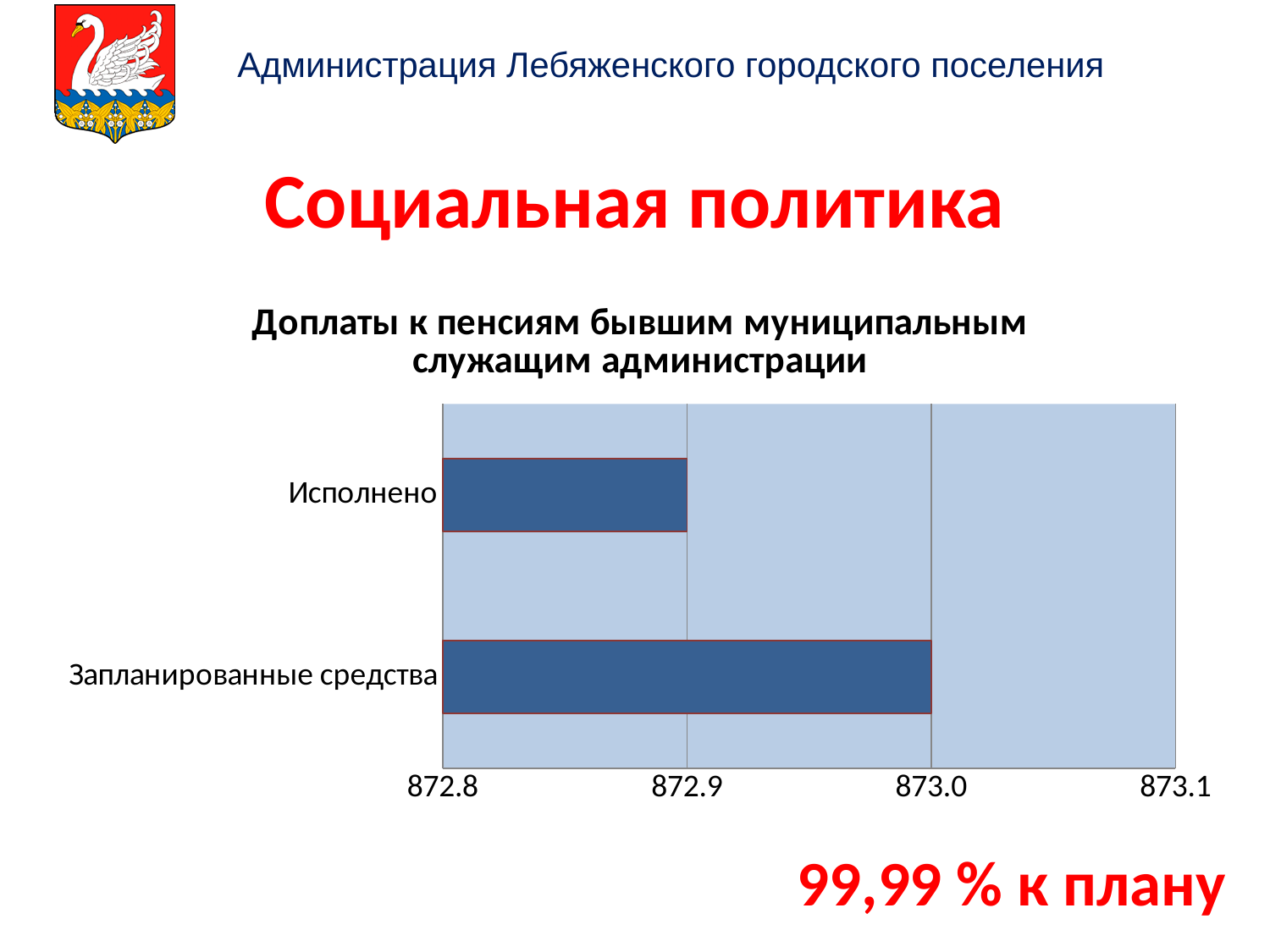
Which category has the lower value? Исполнено How many categories are plotted in the chart? 2 What percentage of the plan is stated below the chart? 99,99 % к плану What is the title of the chart? Доплаты к пенсиям бывшим муниципальным служащим администрации What is the value for Исполнено? 872.9 What is the value for Запланированные средства? 873.0 Is the value for Запланированные средства larger or smaller than the value for Исполнено? Larger Is the value for Запланированные средства greater or less than 872.9? greater What is the difference between the values for Запланированные средства and Исполнено? 0.1 Is the value for Исполнено greater or less than 873.0? less Which category has the higher value? Запланированные средства What kind of chart is shown on the slide? Bar chart